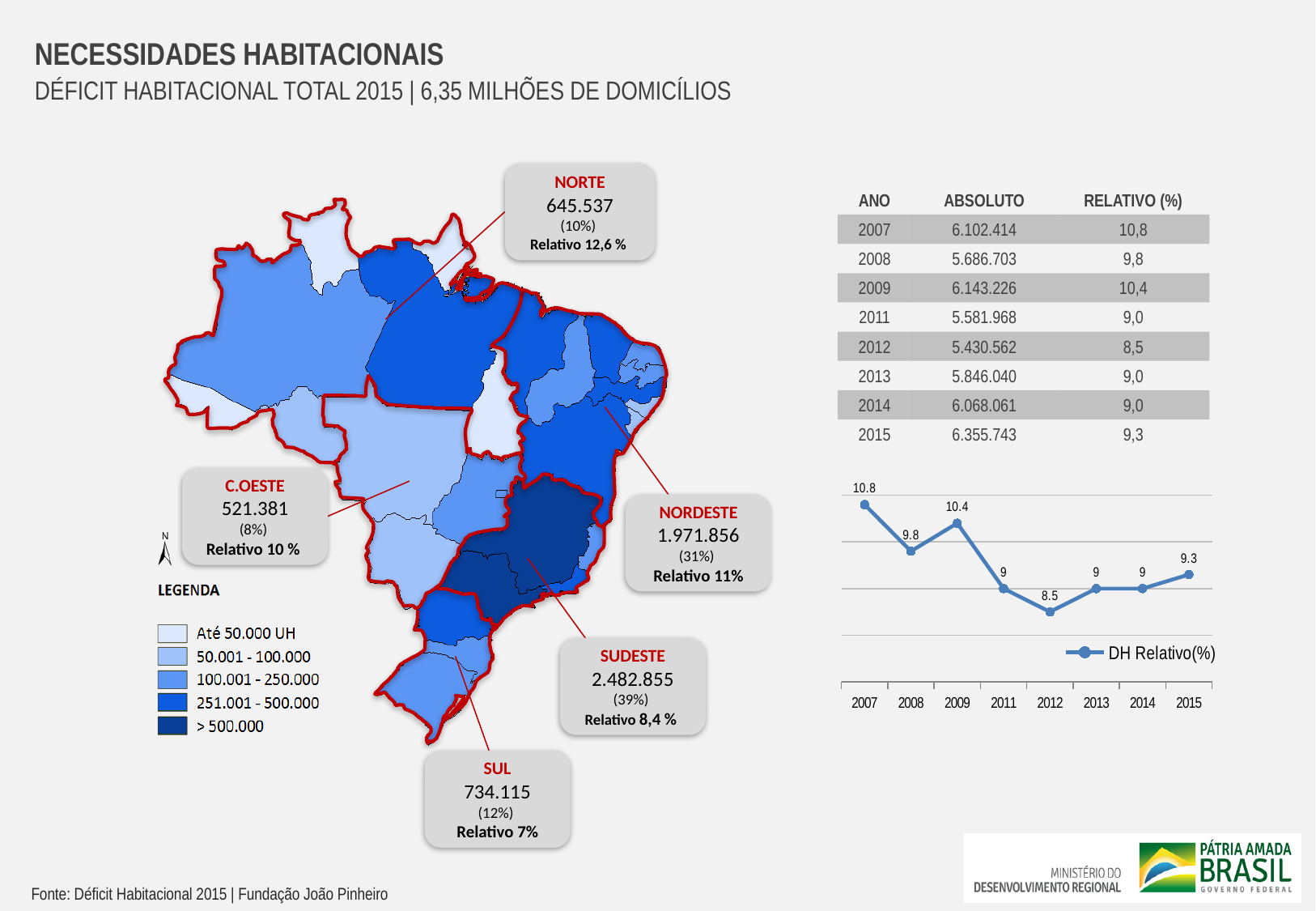
What is the name of the series shown in the legend of the line chart? DH Relativo(%) In the line chart, what is the DH Relativo(%) value for 2015? 9.3 How many series does the legend of the line chart list? 1 In the line chart, does the DH Relativo(%) value rise or fall from 2007 to 2008? Fall In the line chart, what is the DH Relativo(%) value for 2012? 8.5 In the line chart, what is the DH Relativo(%) value for 2007? 10.8 In the line chart, what is the difference between the DH Relativo(%) values for 2007 and 2012? 2.3 In the line chart, which is larger, the DH Relativo(%) value for 2008 or for 2009? 2009 What kind of chart is shown on the right side of the slide below the table? Line chart How many years are plotted on the x axis of the line chart? 8 In the line chart, which year has the lowest DH Relativo(%) value? 2012 In the line chart, which year has the highest DH Relativo(%) value? 2007